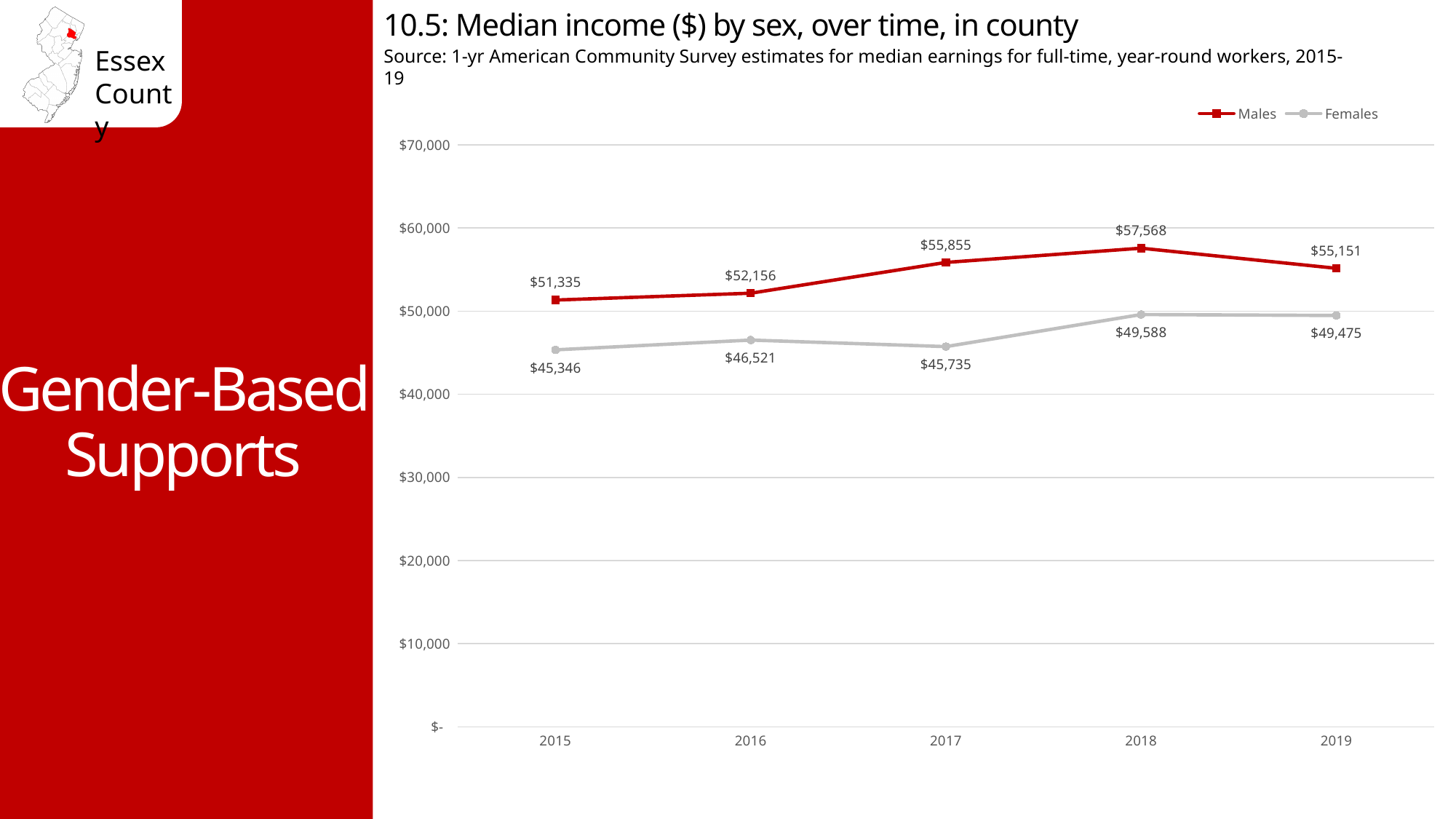
Which was larger in 2016, the median income for Males or for Females? Males How many years are shown on the x axis? 5 What kind of chart is shown on the slide? line chart What was the median income for Males in 2018? $57,568 Did the median income for Males rise or fall from 2018 to 2019? fall What was the median income for Females in 2015? $45,346 Is the median income for Females in 2018 greater or less than $50,000? less What is the difference between the Males and Females median income in 2019? $5,676 In which year was the median income for Females lowest? 2015 How many series does the legend list? 2 In which year was the median income for Males highest? 2018 What was the median income for Females in 2017? $45,735